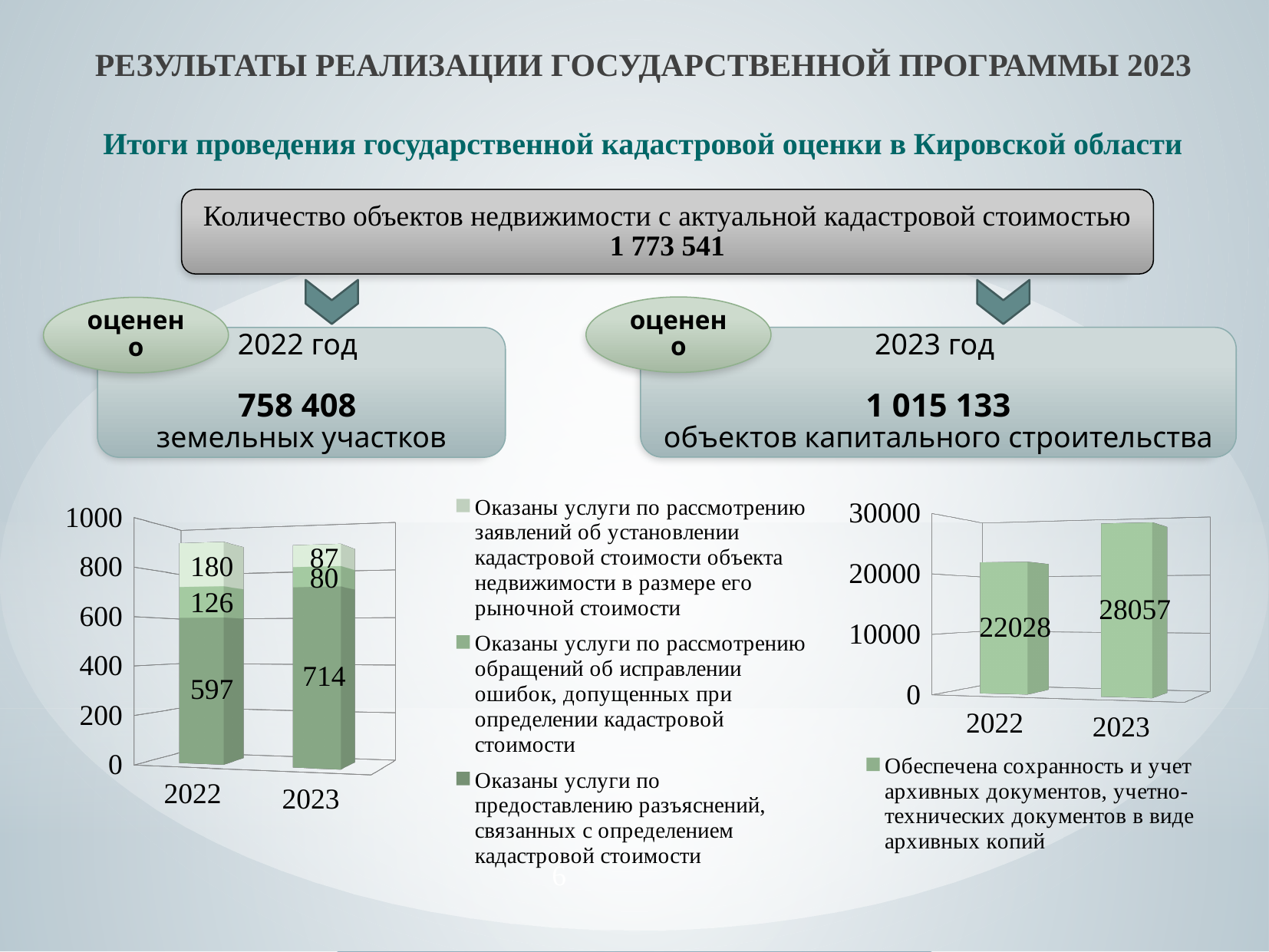
In the right bar chart, which year has the higher value? 2023 In the right bar chart, what is the value for 2023? 28057 In the left stacked bar chart, what is the total of the 2022 bar? 903 In the left stacked bar chart, what is the value of the largest (bottom) segment for 2022? 597 In the left stacked bar chart, what is the total of the 2023 bar? 881 In the left stacked bar chart, what is the value of the top (lightest) segment for 2022? 180 In the left stacked bar chart, what is the difference between the bottom segment values for 2023 and 2022? 117 In the right bar chart, what is the value for 2022? 22028 What kind of chart is shown on the right side of the slide? Bar chart In the left stacked bar chart, what is the value of the bottom segment for 2023? 714 In the right bar chart, what is the difference between the 2023 and 2022 values? 6029 How many series does the legend of the left stacked bar chart list? 3